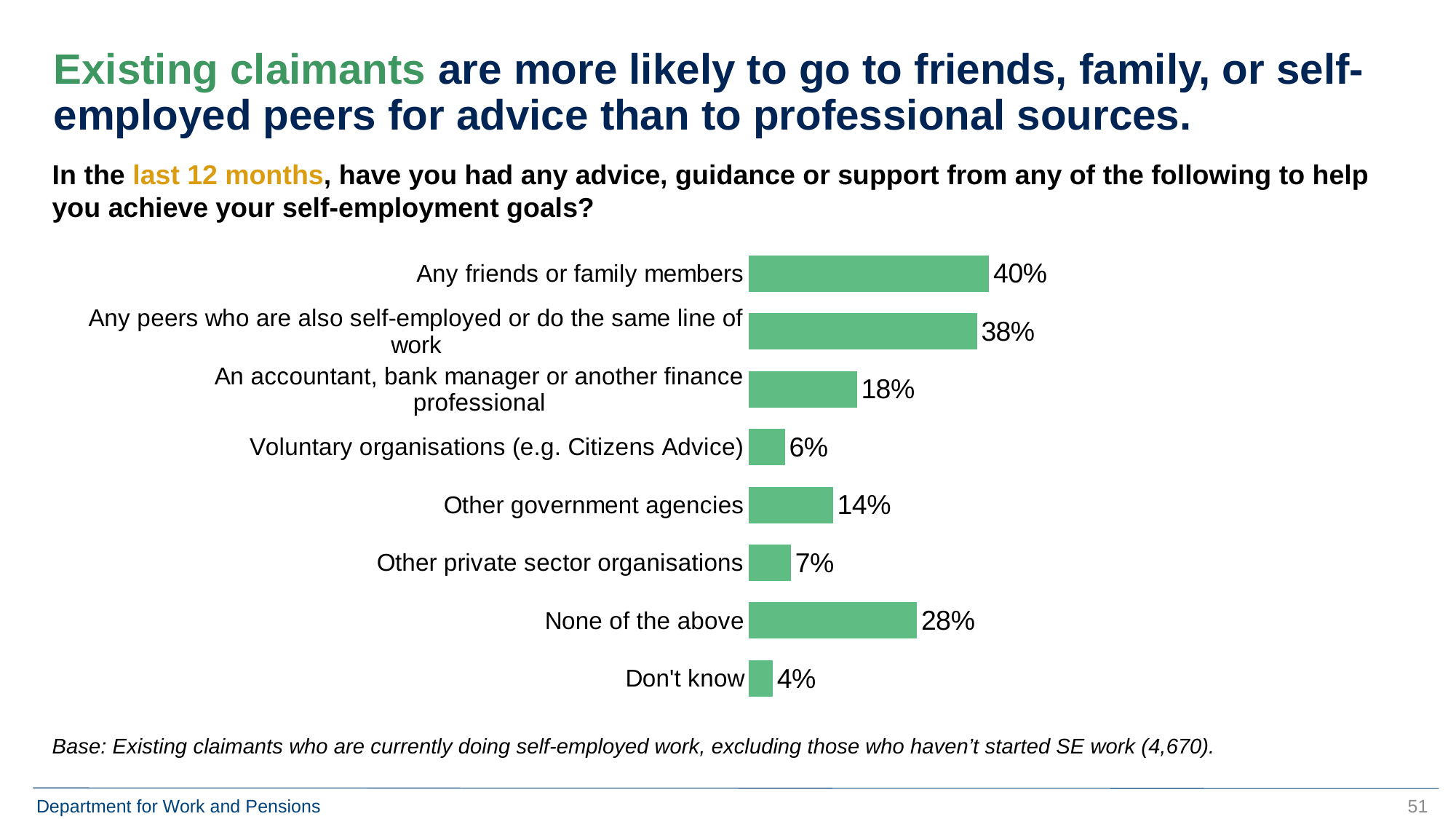
Which category has the lowest value? Don't know Which is larger: the value for 'None of the above' or the value for 'An accountant, bank manager or another finance professional'? None of the above What is the difference between the value for 'Any friends or family members' and the value for 'An accountant, bank manager or another finance professional'? 22% Which category has the highest value? Any friends or family members What is the value for 'Voluntary organisations (e.g. Citizens Advice)'? 6% What kind of chart is shown on the slide? Bar chart What is the difference between 'Other government agencies' and 'Other private sector organisations'? 7% What is the value for 'Other government agencies'? 14% How many categories are shown in the chart? 8 What percentage of existing claimants had advice from any friends or family members? 40% What percentage answered 'None of the above'? 28% What colour are the bars in the chart? Green